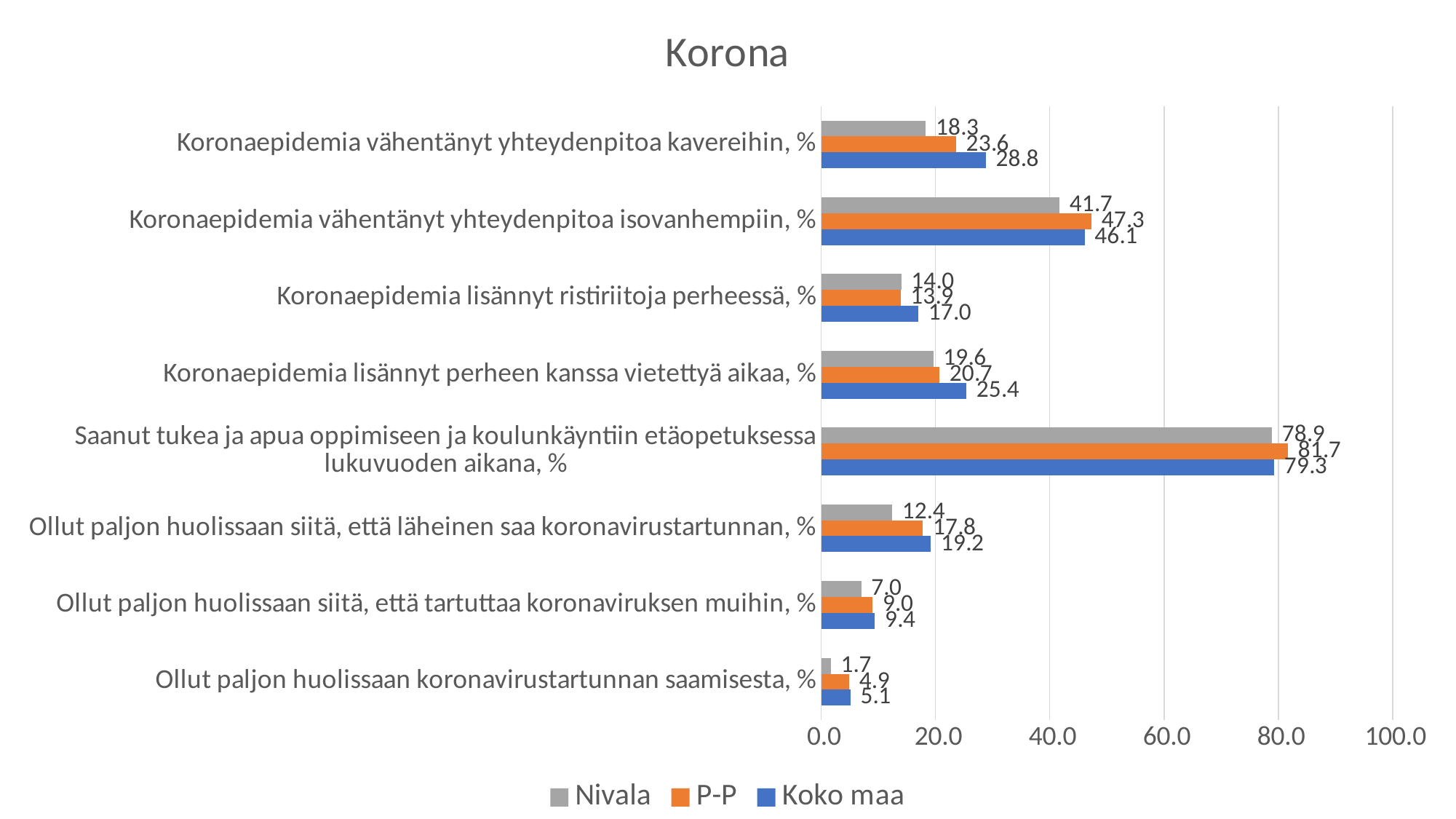
Which category has the highest Koko maa value? Saanut tukea ja apua oppimiseen ja koulunkäyntiin etäopetuksessa lukuvuoden aikana, % How many series does the legend list? 3 What type of chart is shown on the slide? Bar chart Which category has the lowest P-P value? Ollut paljon huolissaan koronavirustartunnan saamisesta, % What is the Nivala value for "Ollut paljon huolissaan koronavirustartunnan saamisesta, %"? 1.7 What is the Koko maa value for "Koronaepidemia vähentänyt yhteydenpitoa isovanhempiin, %"? 46.1 What is the difference between the Koko maa and Nivala values for "Koronaepidemia vähentänyt yhteydenpitoa kavereihin, %"? 10.5 For "Koronaepidemia lisännyt perheen kanssa vietettyä aikaa, %", which is larger: the Nivala value or the Koko maa value? Koko maa What is the Nivala value for "Koronaepidemia vähentänyt yhteydenpitoa kavereihin, %"? 18.3 How many categories are shown on the chart? 8 Is the P-P value for "Koronaepidemia vähentänyt yhteydenpitoa isovanhempiin, %" greater or less than 40.0? greater What is the P-P value for "Saanut tukea ja apua oppimiseen ja koulunkäyntiin etäopetuksessa lukuvuoden aikana, %"? 81.7